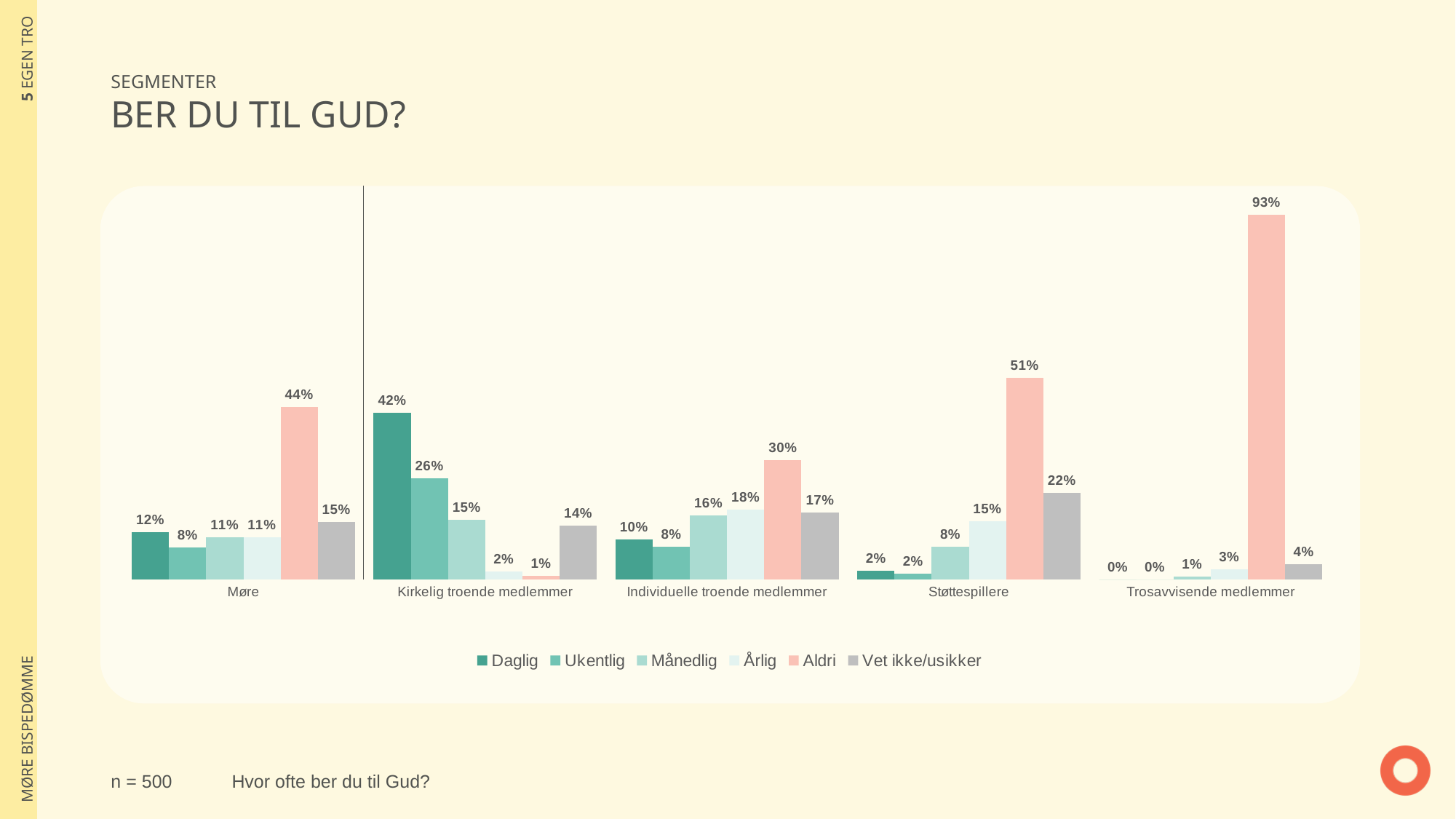
What kind of chart is shown on the slide? Bar chart What is the difference between the Aldri value for Støttespillere and the Aldri value for Møre? 7% What is the value for Vet ikke/usikker in the Støttespillere category? 22% How many series does the legend list? 6 Which category has the lowest value for Daglig? Trosavvisende medlemmer Which is larger: Ukentlig for Kirkelig troende medlemmer or Aldri for Individuelle troende medlemmer? Aldri for Individuelle troende medlemmer How many categories are shown on the x axis? 5 What is the value for Aldri in the Trosavvisende medlemmer category? 93% What is the value for Daglig in the Kirkelig troende medlemmer category? 42% Which category has the highest value for Aldri? Trosavvisende medlemmer What is the sample size noted on the slide? n = 500 What is the value for Årlig in the Individuelle troende medlemmer category? 18%